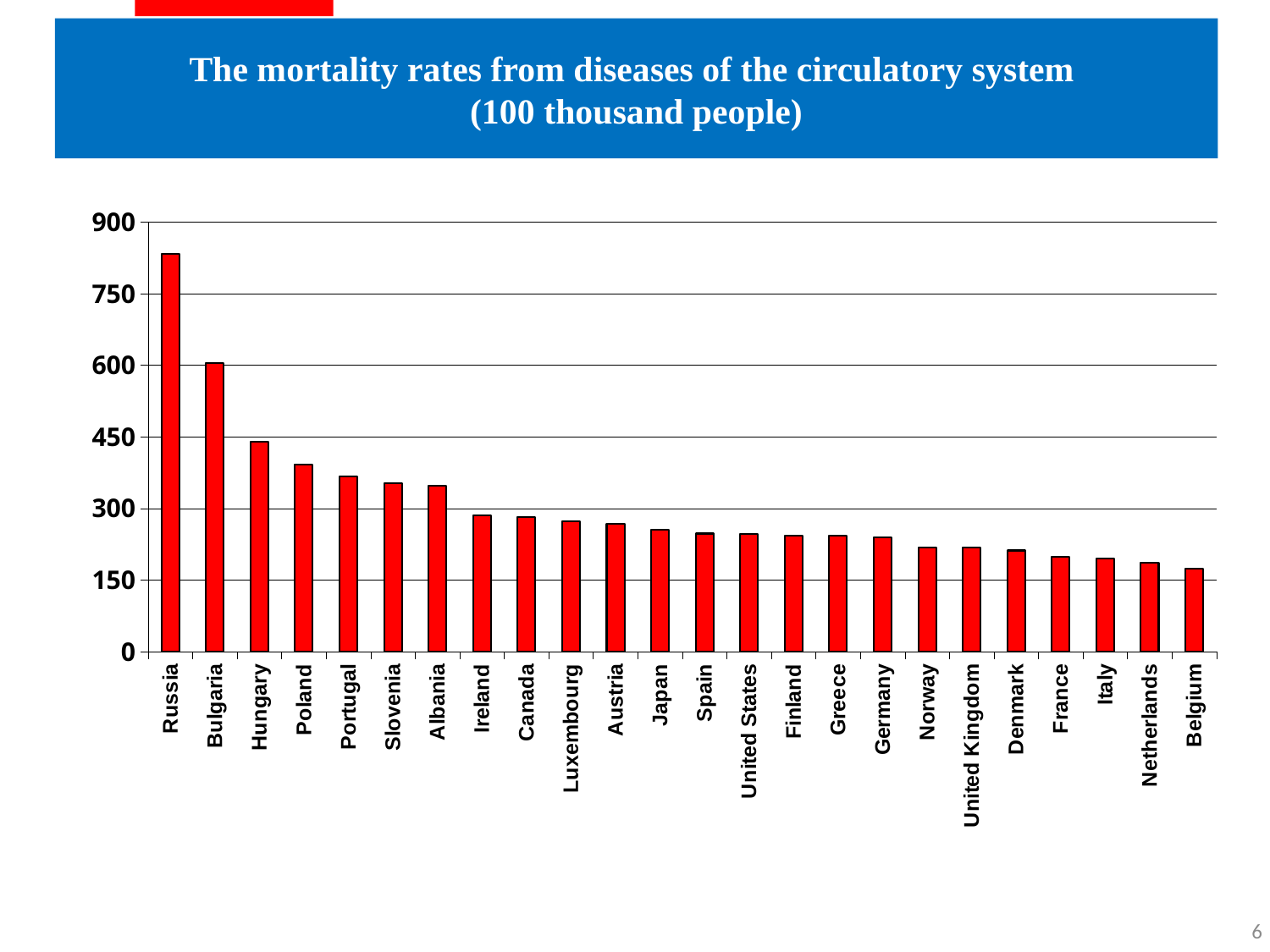
Is the value for Belgium greater or less than 300? less How many countries are shown in the chart? 24 What is the title of the chart on the slide? The mortality rates from diseases of the circulatory system (100 thousand people) Which has a lower mortality rate, Hungary or Netherlands? Netherlands Which country has the highest mortality rate in the chart? Russia What kind of chart is shown on the slide? Bar chart Is the value for Hungary greater or less than 600? less Is the value for Russia greater or less than 750? greater Which has a higher mortality rate, Poland or Ireland? Poland Which country has the lowest mortality rate in the chart? Belgium Do the values rise or fall from left to right along the x axis? Fall